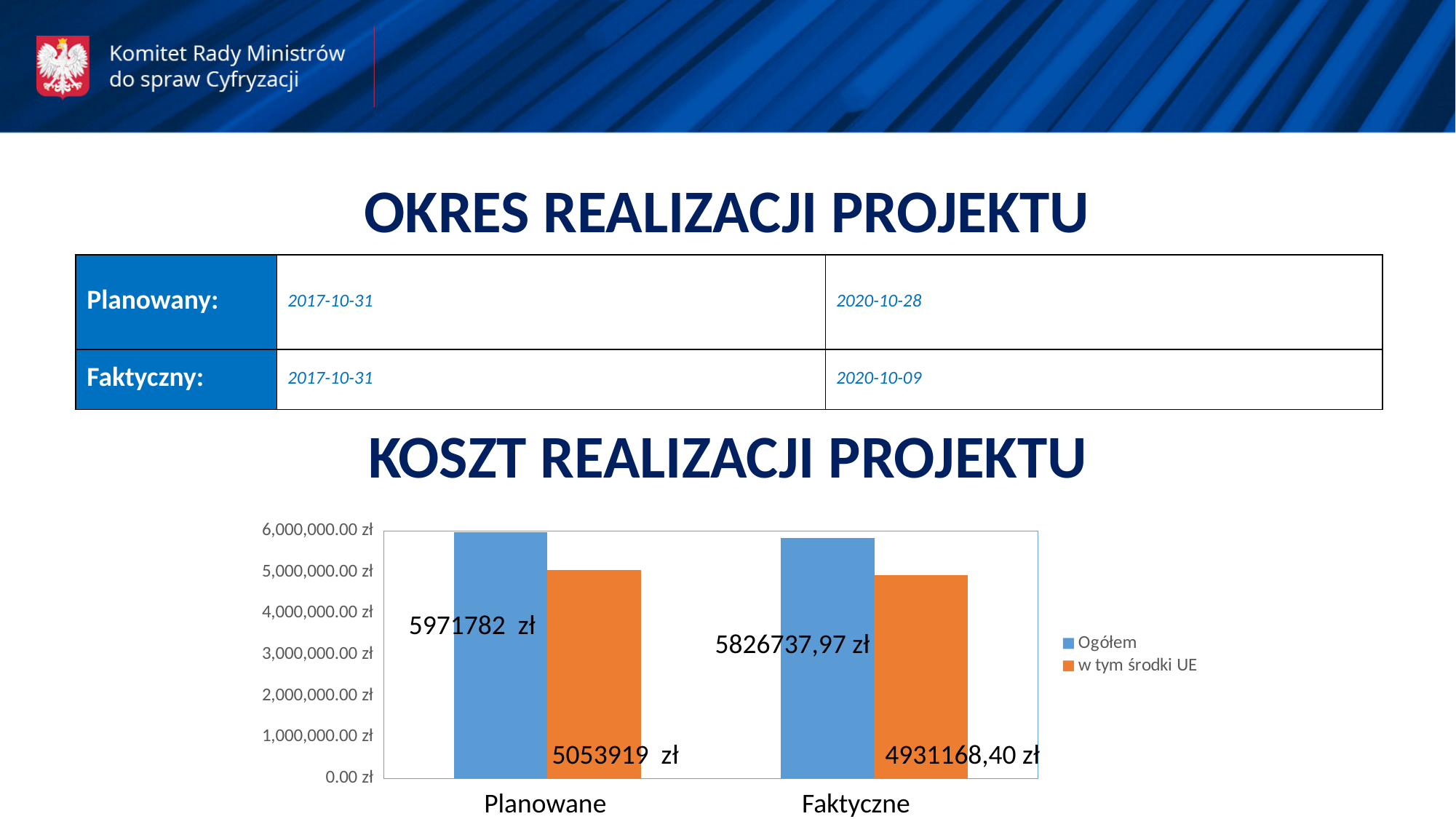
What is the Ogółem value for Planowane in the cost chart? 5971782 zł Which bar in the cost chart has the highest value? Planowane, Ogółem What is the w tym środki UE value for Faktyczne in the cost chart? 4931168,40 zł Is the Ogółem value for Faktyczne in the cost chart greater or less than 5,000,000.00 zł? greater Which series in the cost chart is shown in orange? w tym środki UE Which bar in the cost chart has the lowest value? Faktyczne, w tym środki UE What is the Ogółem value for Faktyczne in the cost chart? 5826737,97 zł What is the w tym środki UE value for Planowane in the cost chart? 5053919 zł What is the difference between the Ogółem and w tym środki UE values for Planowane in the cost chart? 917863 zł How many series does the legend of the cost chart list? 2 What type of chart is shown under the heading KOSZT REALIZACJI PROJEKTU? bar chart How many categories are shown on the x axis of the cost chart? 2